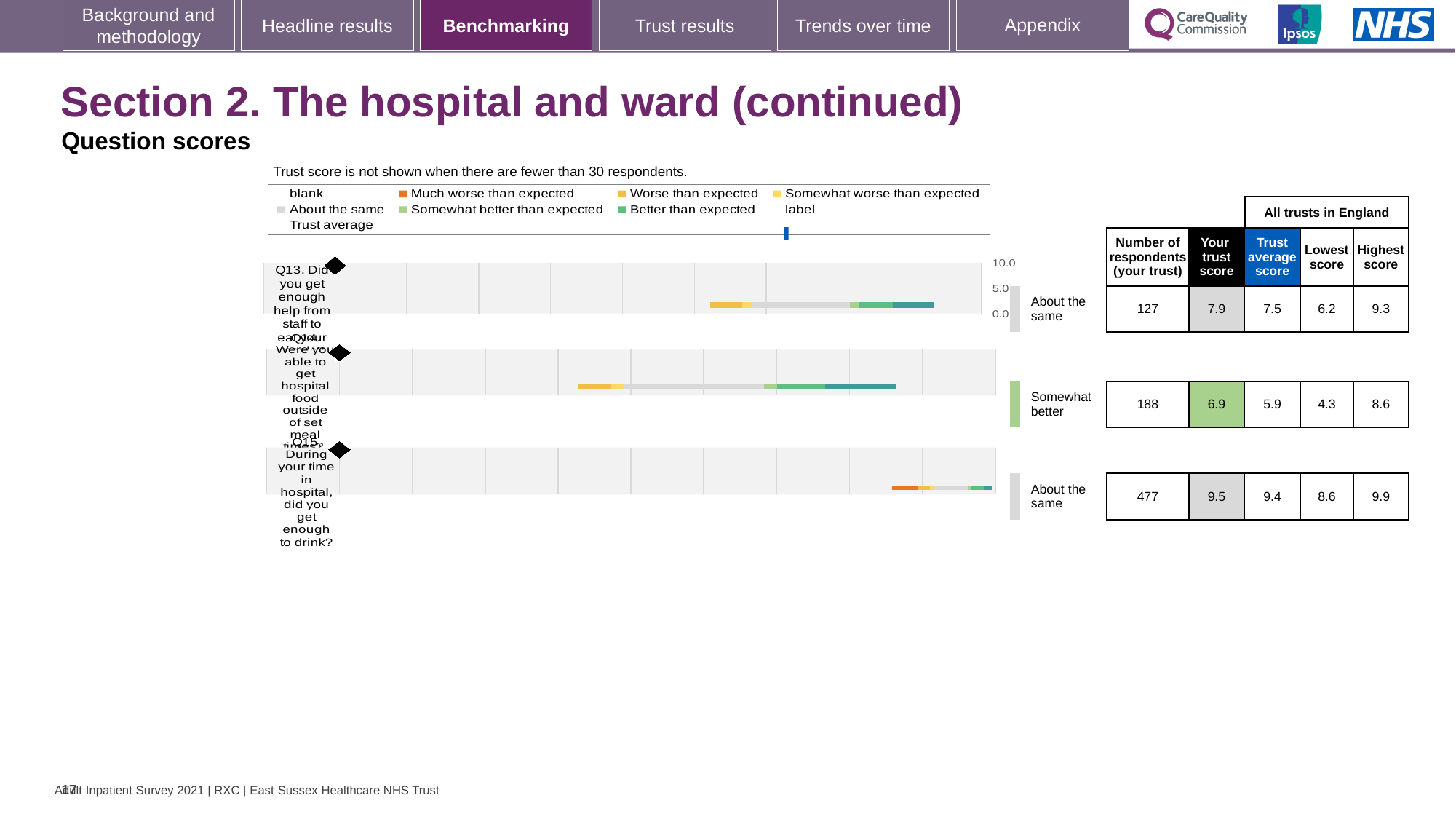
For Q13, which is larger: the trust score or the all-England trust average score? the trust score How many respondents answered Q15 for this trust? 477 What is the trust average score across all trusts in England for Q14? 5.9 Which question has the highest trust score on this slide? Q15 What is the difference between the trust score and the all-England trust average for Q14? 1.0 What is the trust score for Q14 (able to get hospital food outside of set meal times)? 6.9 What is the trust score for Q15 (enough to drink during your time in hospital)? 9.5 How many questions (Q13, Q14, Q15) are plotted on the slide? 3 What kind of chart is used to show the question scores on this slide? bar chart Which question has the lowest trust score on this slide? Q14 What is the trust score for Q13 (enough help from staff to eat meals)? 7.9 What benchmark category is shown for Q14? Somewhat better